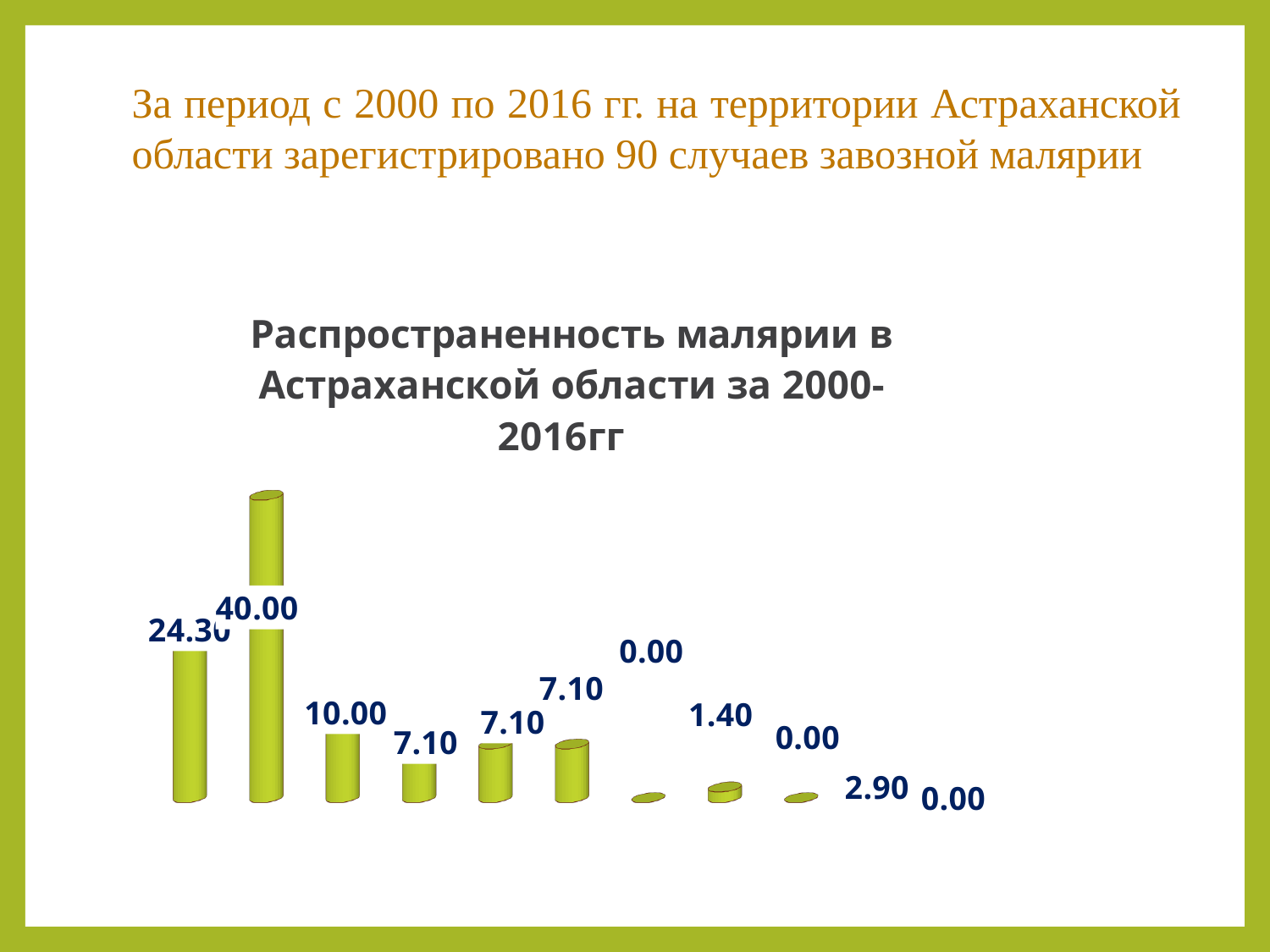
How many data labels are shown on the chart? 11 What is the value labelled on the third bar from the left? 10.00 What is the difference between the second bar's value (40.00) and the first bar's value (24.30)? 15.70 Which is larger, the first bar (24.30) or the third bar (10.00)? the first bar After the second bar, do the values generally rise or fall moving to the right? fall What is the highest value labelled on the chart? 40.00 What is the lowest value labelled on the chart? 0.00 Which bar is the tallest in the chart? the second bar What kind of chart is shown on the slide? bar chart How many data labels show the value 7.10? 3 What is the title of the chart? Распространенность малярии в Астраханской области за 2000-2016гг What is the value labelled on the first (leftmost) bar? 24.30